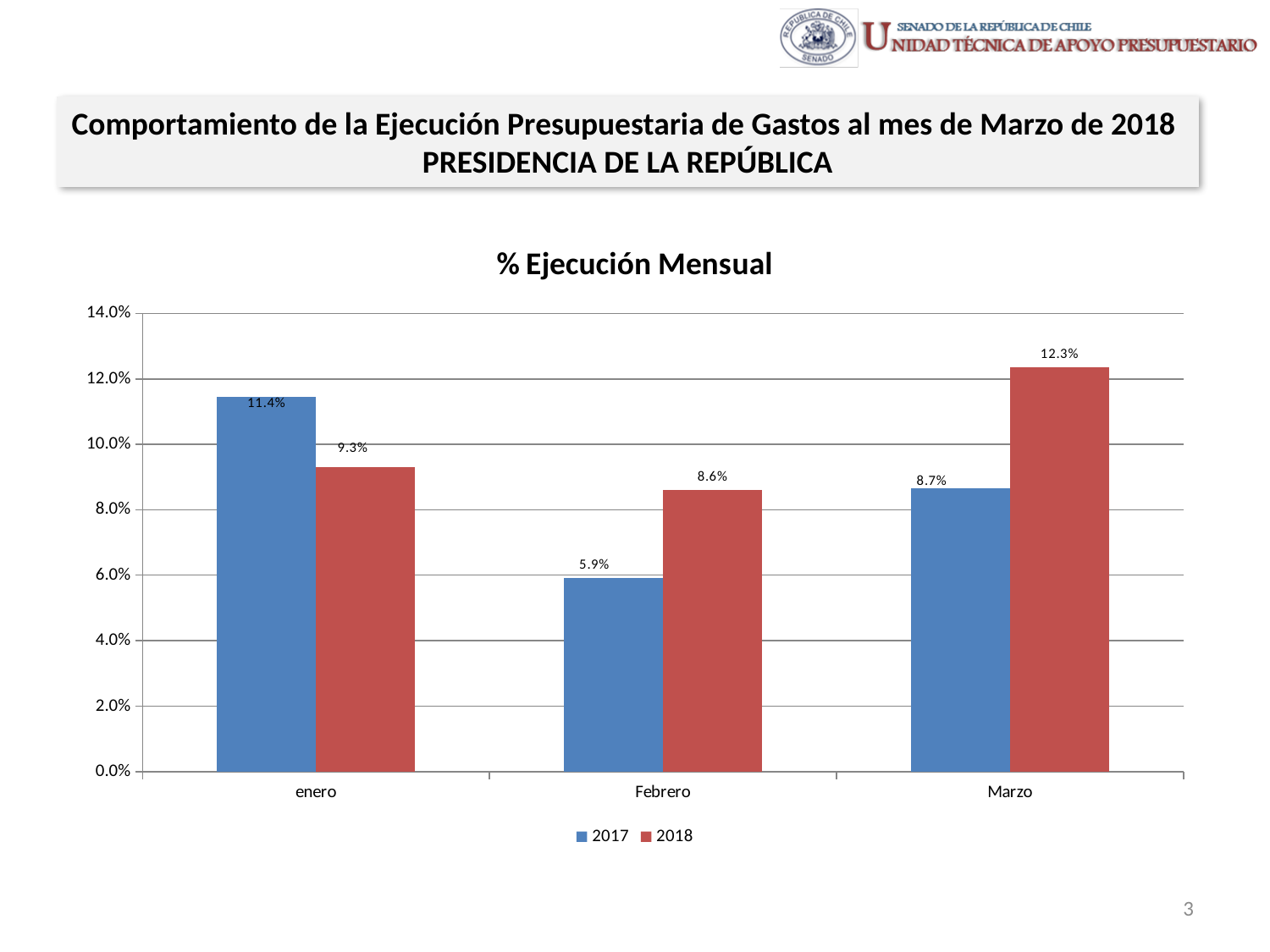
Which month has the highest value for the 2018 series? Marzo What is the value for 2017 in Febrero? 5.9% How many series does the legend list? 2 What is the title of the chart? % Ejecución Mensual What is the difference between the 2018 and 2017 values in Marzo? 3.6% What is the value for 2018 in Marzo? 12.3% How many months are shown on the x axis? 3 What is the value for 2018 in enero? 9.3% Which month has the lowest value for the 2017 series? Febrero What kind of chart is shown? Bar chart What is the value for 2017 in enero? 11.4% Which is larger in enero, the 2017 value or the 2018 value? 2017